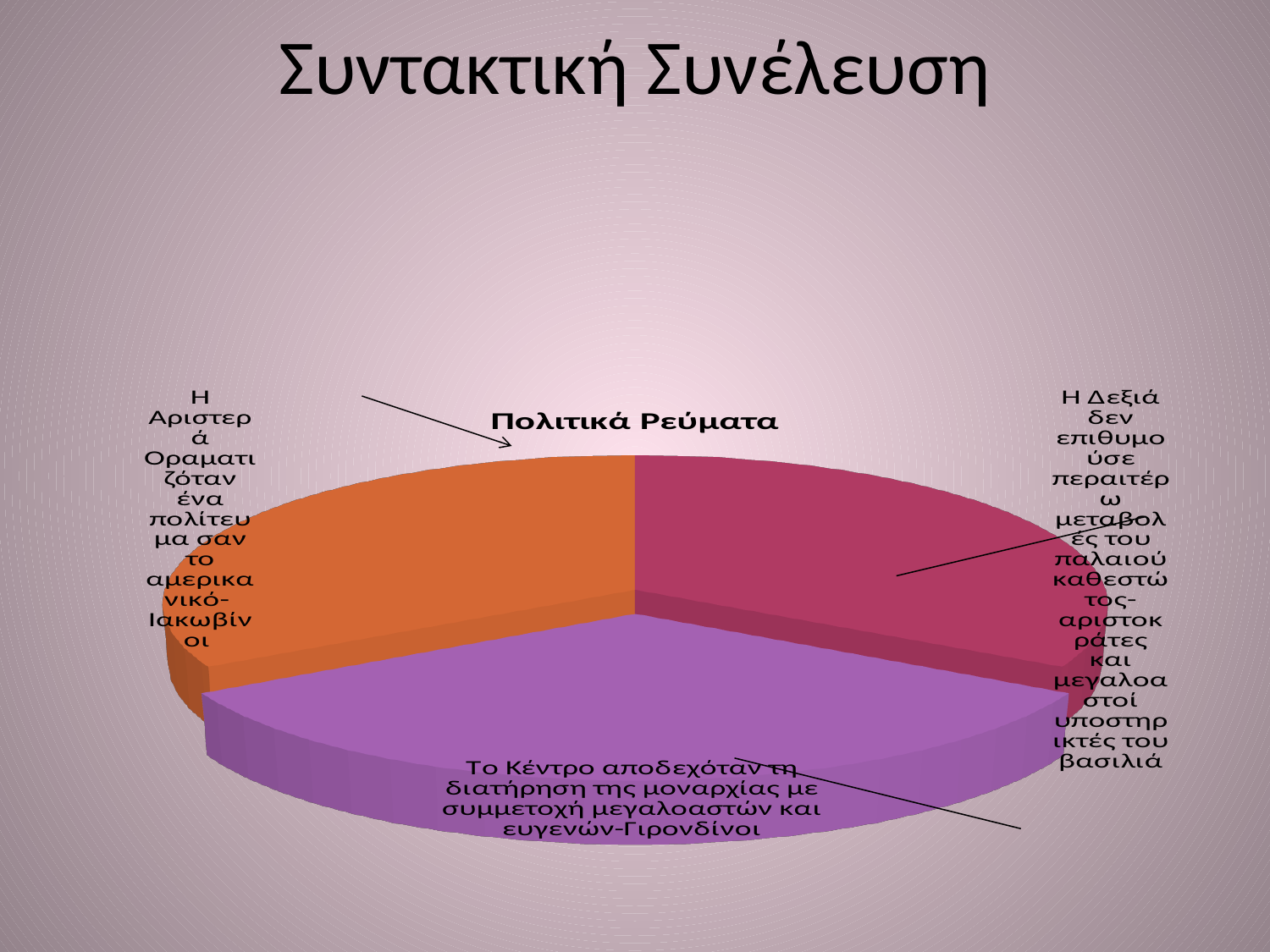
Does the Centre (Γιρονδίνοι) slice take up more or less than a quarter of the pie? more What kind of chart is shown on the slide? pie chart What colour is the slice representing the Centre (Γιρονδίνοι)? purple What is the title of the pie chart? Πολιτικά Ρεύματα How many slices does the pie chart have? 3